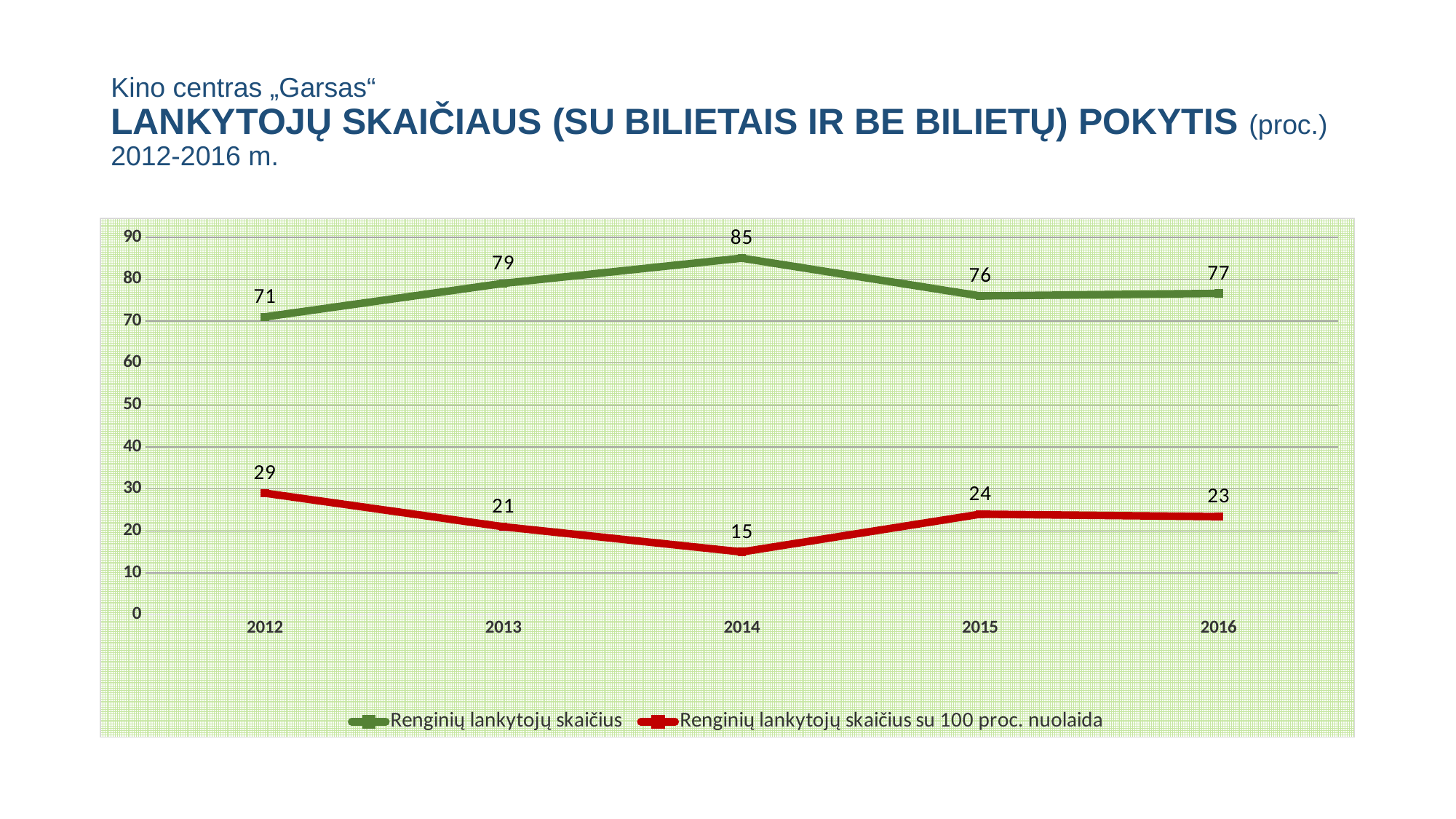
Which is larger: "Renginių lankytojų skaičius su 100 proc. nuolaida" in 2015 or in 2016? 2015 What is the difference between the "Renginių lankytojų skaičius" values for 2014 and 2012? 14 What is the value for "Renginių lankytojų skaičius su 100 proc. nuolaida" in 2012? 29 How many series does the legend list? 2 What is the value for "Renginių lankytojų skaičius" in 2014? 85 What is the difference between the two series' values in 2015? 52 What kind of chart is shown on the slide? line chart Does "Renginių lankytojų skaičius su 100 proc. nuolaida" rise or fall from 2012 to 2014? fall In which year is "Renginių lankytojų skaičius" highest? 2014 In which year is "Renginių lankytojų skaičius su 100 proc. nuolaida" lowest? 2014 What is the value for "Renginių lankytojų skaičius" in 2016? 77 How many years are plotted on the x axis? 5